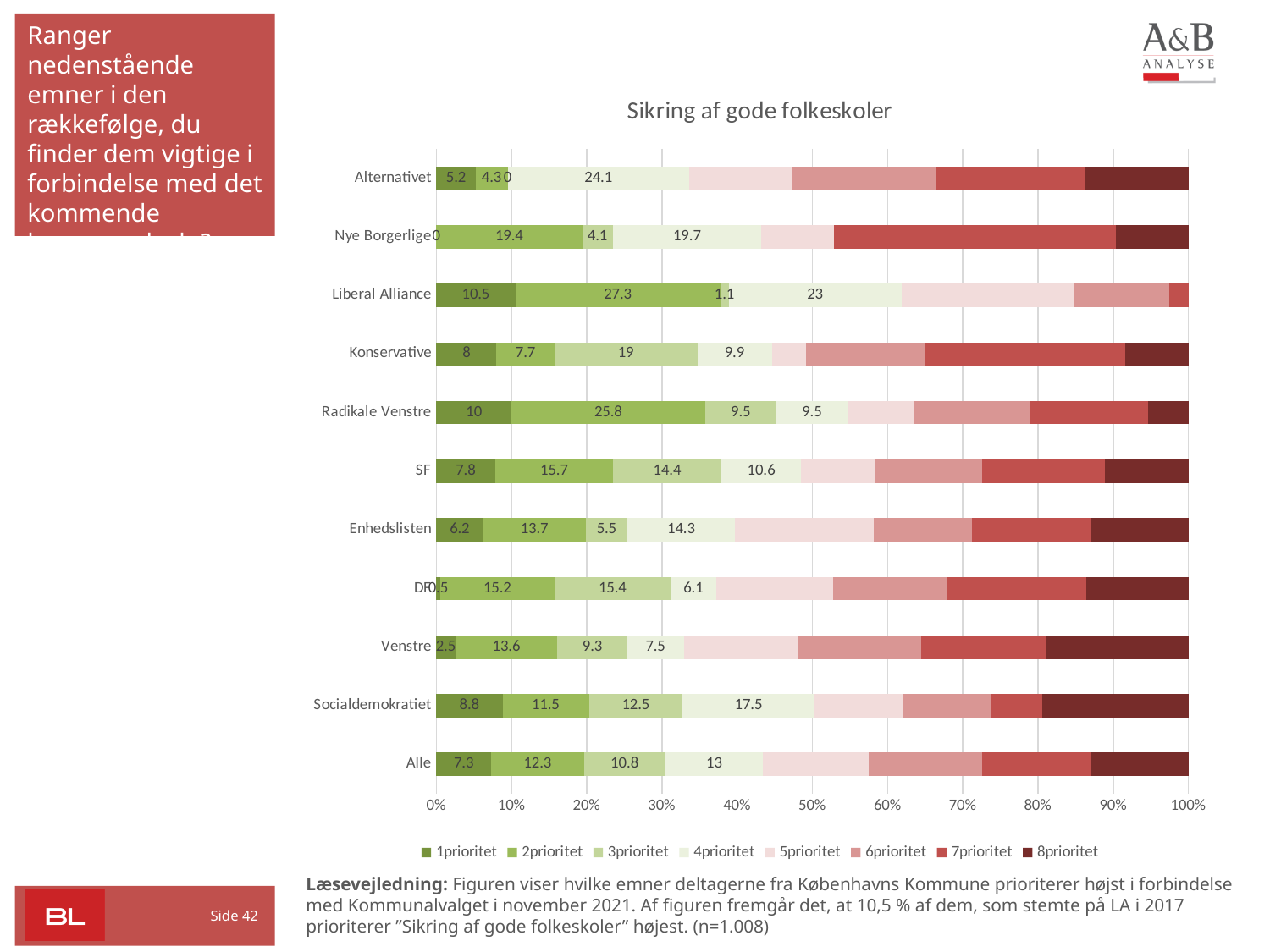
Which category has the lowest 1prioritet value? Nye Borgerlige What is the title of the chart? Sikring af gode folkeskoler What is the difference between the 4prioritet values for Socialdemokratiet and Alle? 4.5 What type of chart is shown on the slide? Stacked bar chart How many categories (parties/groups) are shown on the y axis? 11 What is the 4prioritet value for Alternativet? 24.1 What is the 3prioritet value for Konservative? 19 What is the 2prioritet value for Radikale Venstre? 25.8 Which is larger: the 1prioritet value for SF or for Alle? SF How many series does the legend list? 8 Which category has the highest 2prioritet value? Liberal Alliance What is the 1prioritet value for Liberal Alliance? 10.5